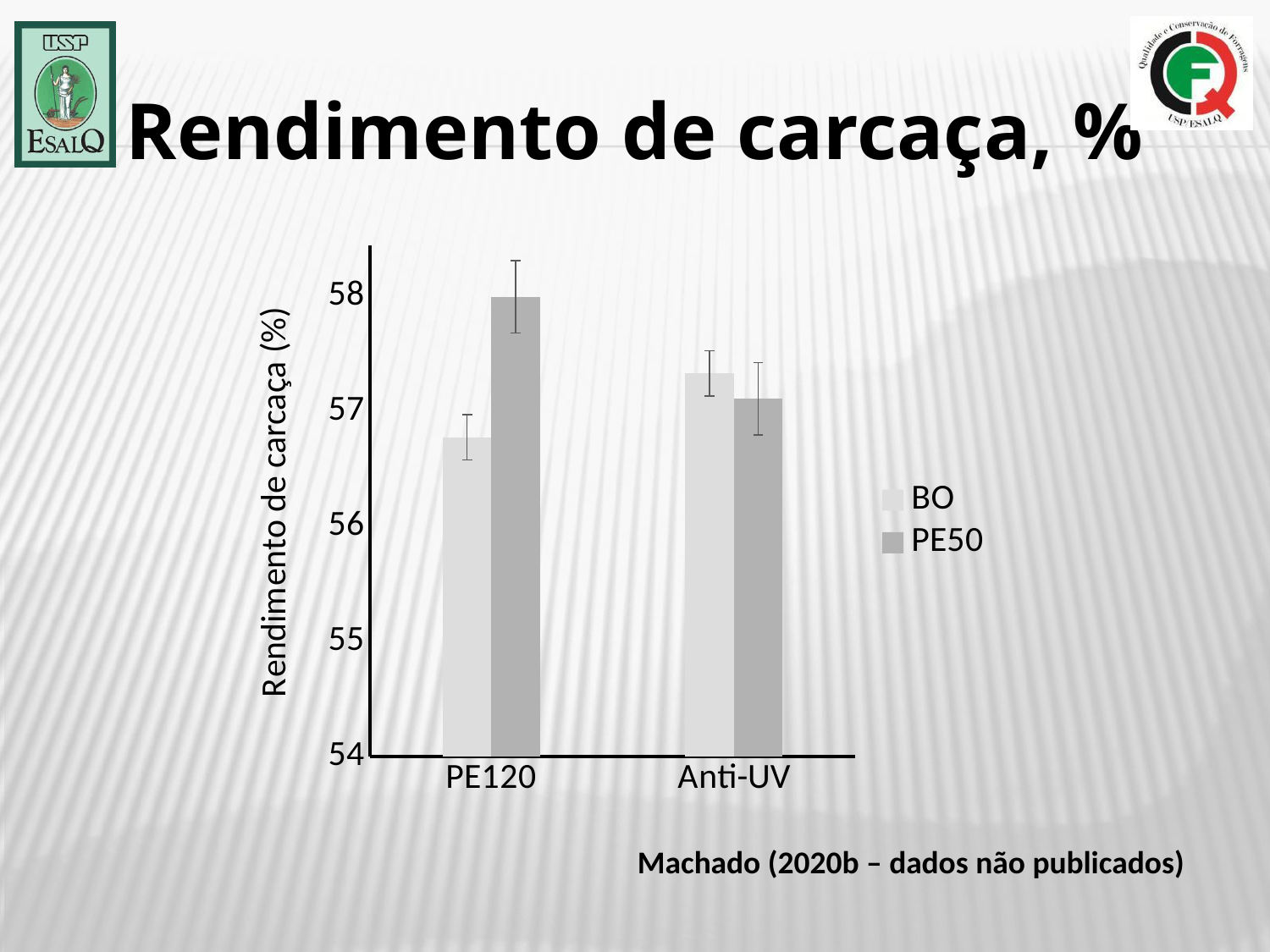
Is the BO value for Anti-UV greater or less than 57? greater Which bar is the highest in the chart? PE50 at PE120 Which bar is the lowest in the chart? BO at PE120 How many categories are shown on the x axis of the chart? 2 Is the BO value for PE120 greater or less than 57? less What is the label of the vertical axis of the chart? Rendimento de carcaça (%) For the PE120 category, which series has the larger value, BO or PE50? PE50 Is the PE50 value for PE120 greater or less than 57? greater Which series are listed in the chart's legend? BO and PE50 What kind of chart is shown on the slide? bar chart How many series does the chart's legend list? 2